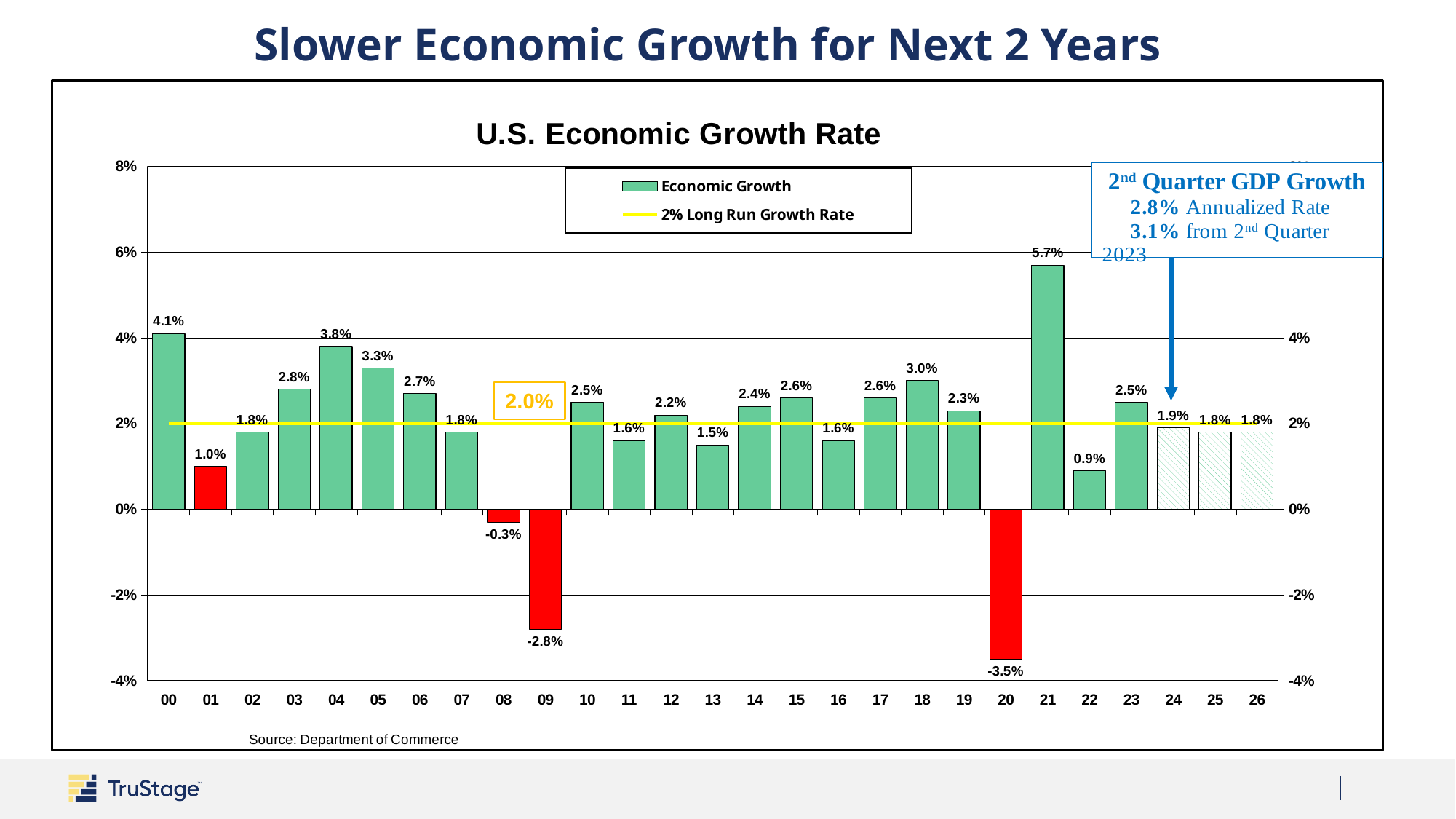
Which year has a higher economic growth rate, 2004 (04) or 2005 (05)? 04 Which year has the highest economic growth rate on the chart? 21 How many years are shown on the x axis of the chart? 27 How many series does the legend list? 2 What value does the yellow horizontal line on the chart represent? 2% Long Run Growth Rate What is the economic growth rate shown for 2009 (09)? -2.8% What is the U.S. economic growth rate shown for 2021 (21)? 5.7% Is the economic growth rate for 2000 (00) greater or less than 4%? greater What kind of chart is used to show the U.S. Economic Growth Rate? Bar chart Which year has the lowest economic growth rate on the chart? 20 What is the difference between the economic growth rate in 2021 (21) and in 2022 (22)? 4.8% What is the economic growth rate shown for 2024 (24)? 1.9%